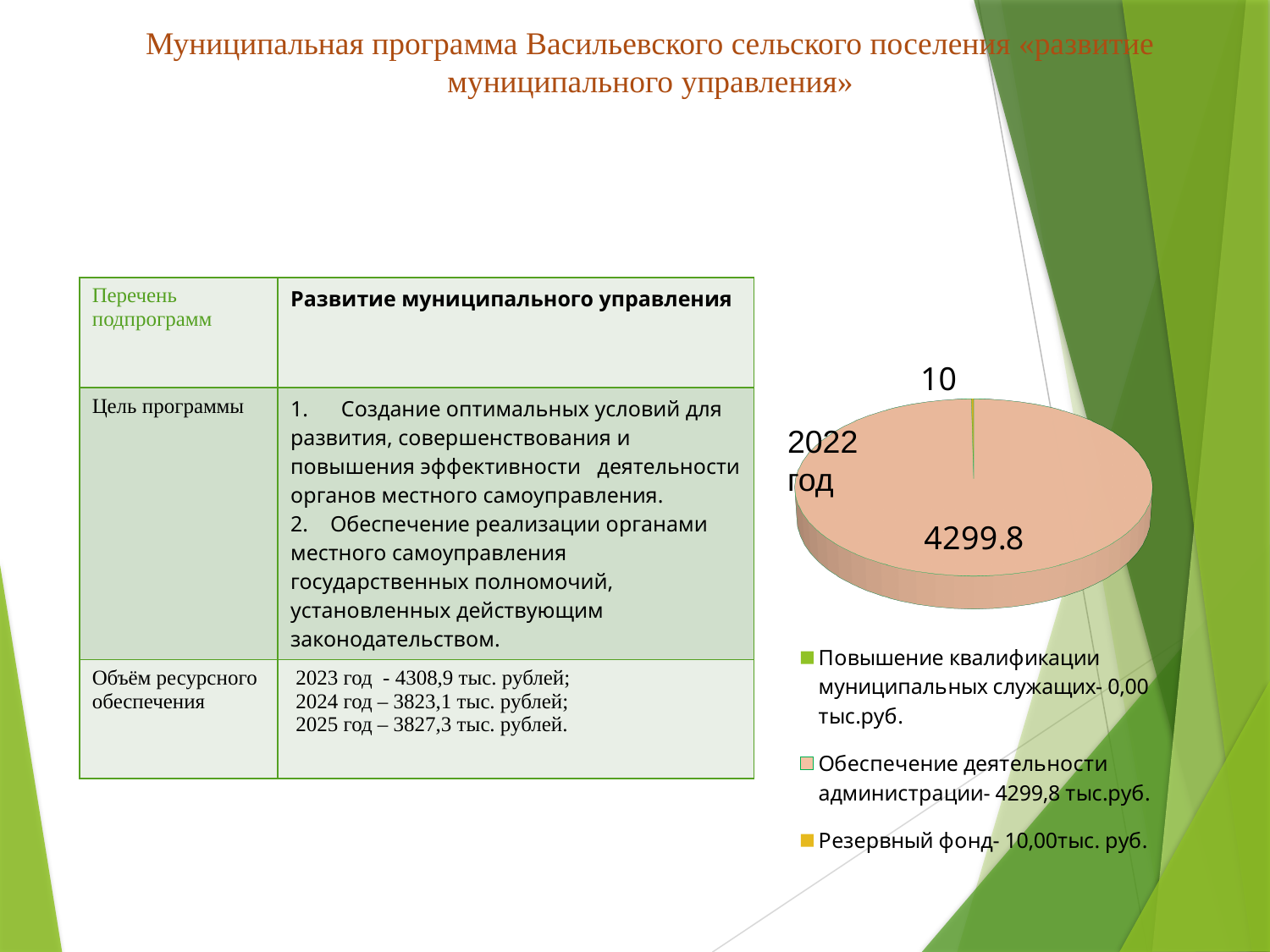
How many entries does the legend of the pie chart list? 3 Which is larger: Обеспечение деятельности администрации or Резервный фонд? Обеспечение деятельности администрации According to the legend, what is the value for Повышение квалификации муниципальных служащих? 0,00 тыс.руб. What value is labelled on the pie chart for Обеспечение деятельности администрации? 4299.8 Which category has the largest slice of the pie chart? Обеспечение деятельности администрации What is the difference between the values for Обеспечение деятельности администрации and Резервный фонд? 4289.8 What colour is the largest slice of the pie chart? peach (light orange) What kind of chart is shown on the slide? pie chart Which category has the smallest value in the pie chart? Повышение квалификации муниципальных служащих What value is labelled on the pie chart for Резервный фонд? 10